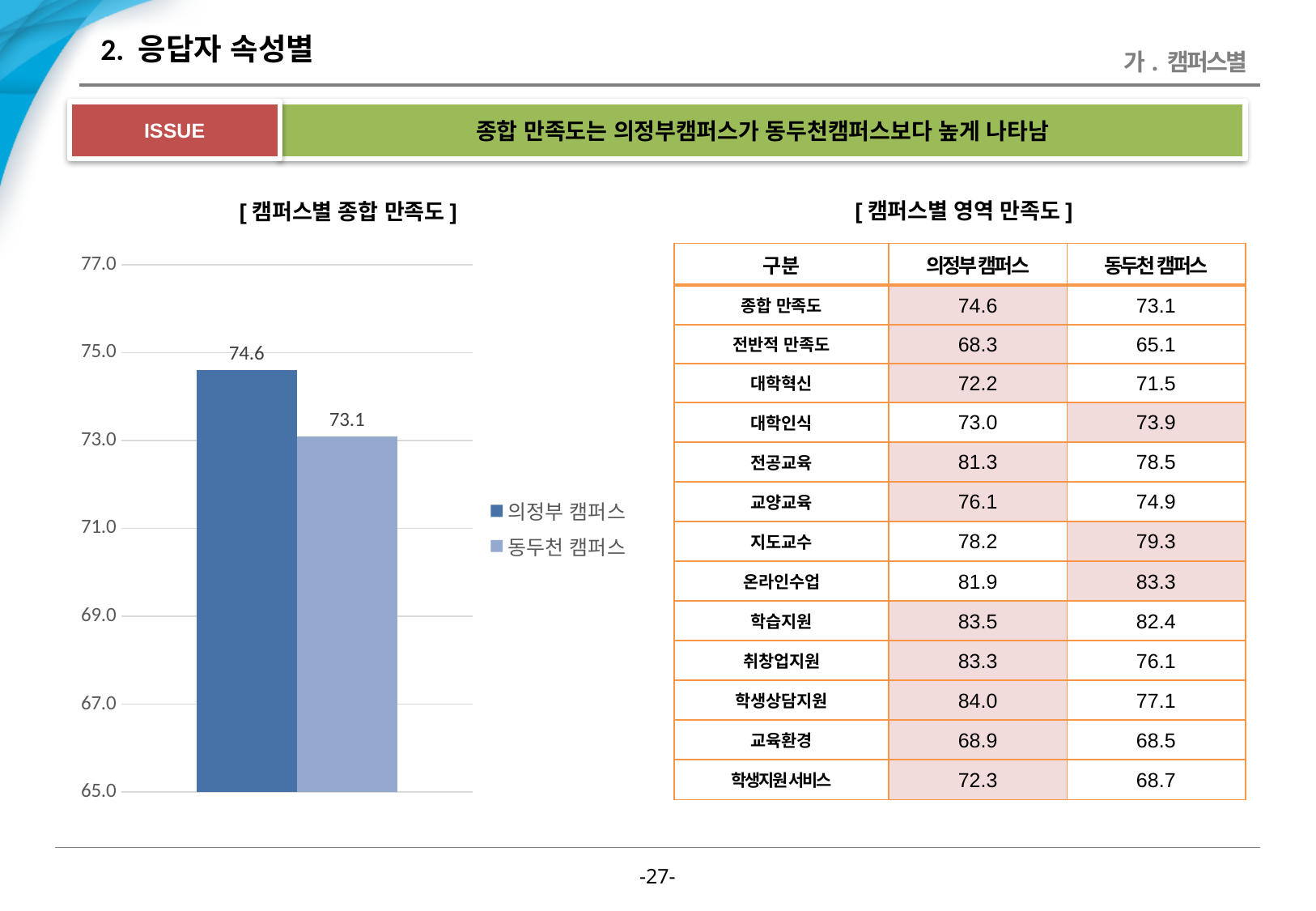
How many series does the legend of the [ 캠퍼스별 종합 만족도 ] chart list? 2 What is the title of the chart on the left side of the slide? [ 캠퍼스별 종합 만족도 ] In the [ 캠퍼스별 종합 만족도 ] chart, is the value for 동두천 캠퍼스 greater or less than 75.0? less In the [ 캠퍼스별 종합 만족도 ] chart, is the value for 의정부 캠퍼스 greater or less than 73.0? greater What is the difference between the 의정부 캠퍼스 and 동두천 캠퍼스 values in the [ 캠퍼스별 종합 만족도 ] chart? 1.5 What kind of chart is the [ 캠퍼스별 종합 만족도 ] chart? bar chart What is the value for 동두천 캠퍼스 in the [ 캠퍼스별 종합 만족도 ] chart? 73.1 Which campus has the higher value in the [ 캠퍼스별 종합 만족도 ] chart? 의정부 캠퍼스 How many bars are plotted in the [ 캠퍼스별 종합 만족도 ] chart? 2 What is the value for 의정부 캠퍼스 in the [ 캠퍼스별 종합 만족도 ] chart? 74.6 In the [ 캠퍼스별 종합 만족도 ] chart, is the value for 의정부 캠퍼스 larger or smaller than the value for 동두천 캠퍼스? larger Which campus has the lower value in the [ 캠퍼스별 종합 만족도 ] chart? 동두천 캠퍼스